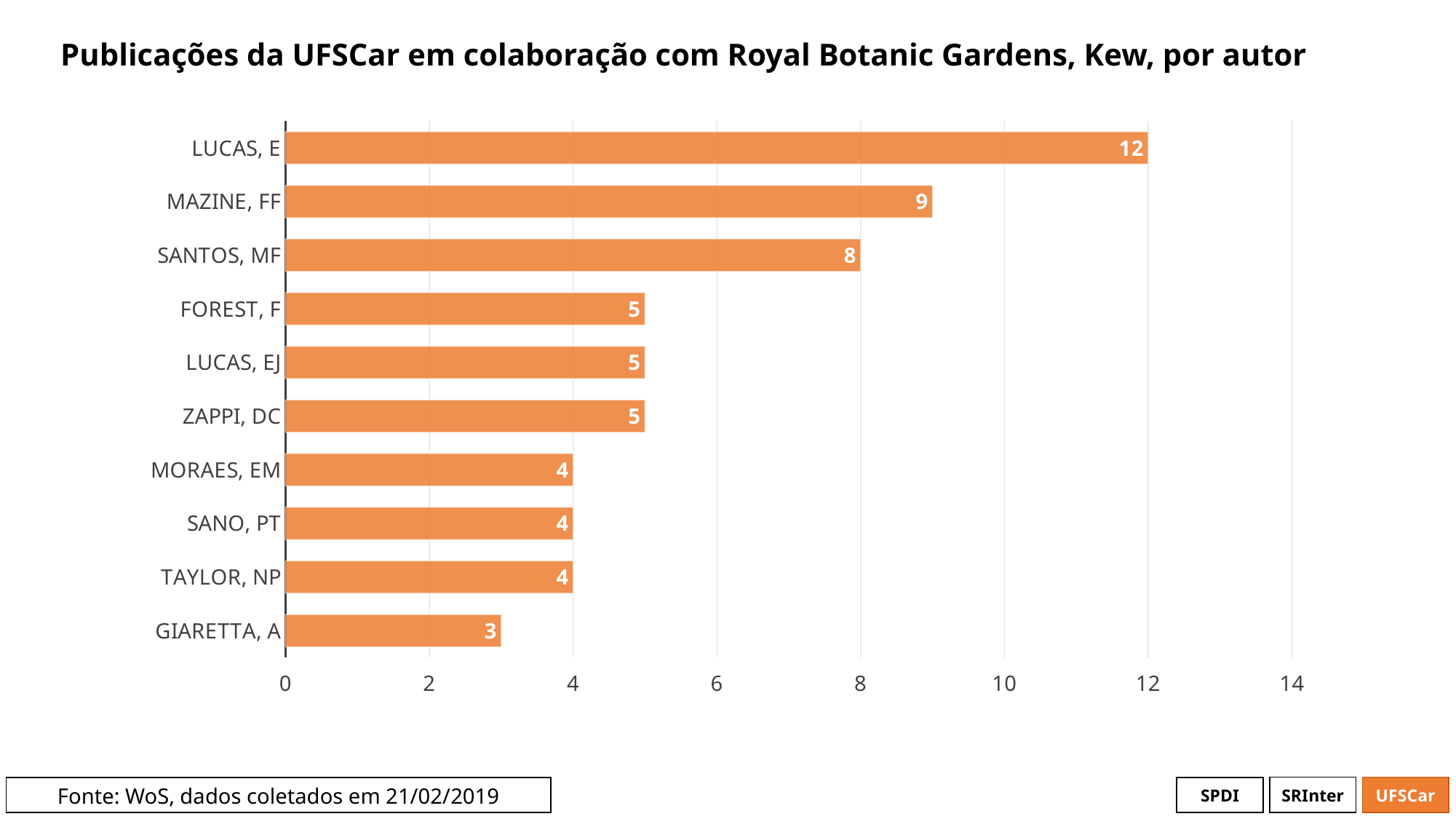
What is the difference between the values for LUCAS, E and MAZINE, FF? 3 What is the value for GIARETTA, A? 3 What is the difference between the values for SANTOS, MF and GIARETTA, A? 5 Which is larger, the value for MAZINE, FF or the value for FOREST, F? MAZINE, FF Is the value for LUCAS, E greater or less than 10? greater How many authors are shown in the chart? 10 What kind of chart is shown on the slide? bar chart Which author has the lowest number of publications? GIARETTA, A What is the title of the chart? Publicações da UFSCar em colaboração com Royal Botanic Gardens, Kew, por autor How many publications does LUCAS, E have? 12 What is the value for SANTOS, MF? 8 Which author has the highest number of publications? LUCAS, E